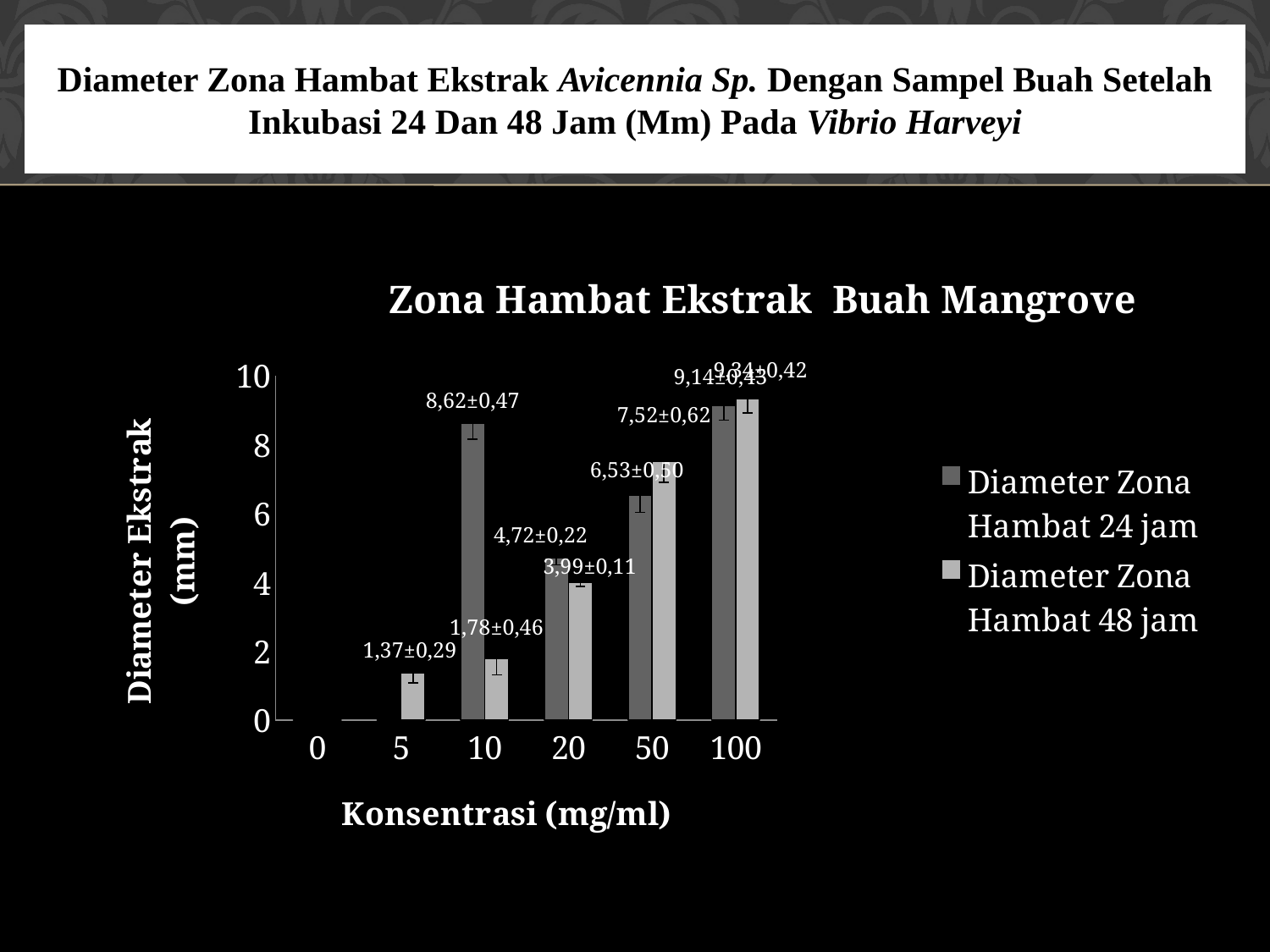
What is the data label for Diameter Zona Hambat 48 jam at 5 mg/ml? 1,37±0,29 What is the data label for Diameter Zona Hambat 24 jam at 100 mg/ml? 9,14±0,43 At 50 mg/ml, which series has the larger value, 24 jam or 48 jam? 48 jam At which concentration is Diameter Zona Hambat 48 jam highest? 100 How many series does the legend list? 2 How many concentration categories are shown on the x axis? 6 What is the data label for Diameter Zona Hambat 24 jam at 50 mg/ml? 6,53±0,50 Is the value for Diameter Zona Hambat 24 jam at 100 mg/ml greater or less than 8? greater What kind of chart is shown on the slide? bar chart What is the data label for Diameter Zona Hambat 48 jam at 100 mg/ml? 9,34±0,42 At 10 mg/ml, which series has the larger value, 24 jam or 48 jam? 24 jam What are the two series named in the legend? Diameter Zona Hambat 24 jam; Diameter Zona Hambat 48 jam